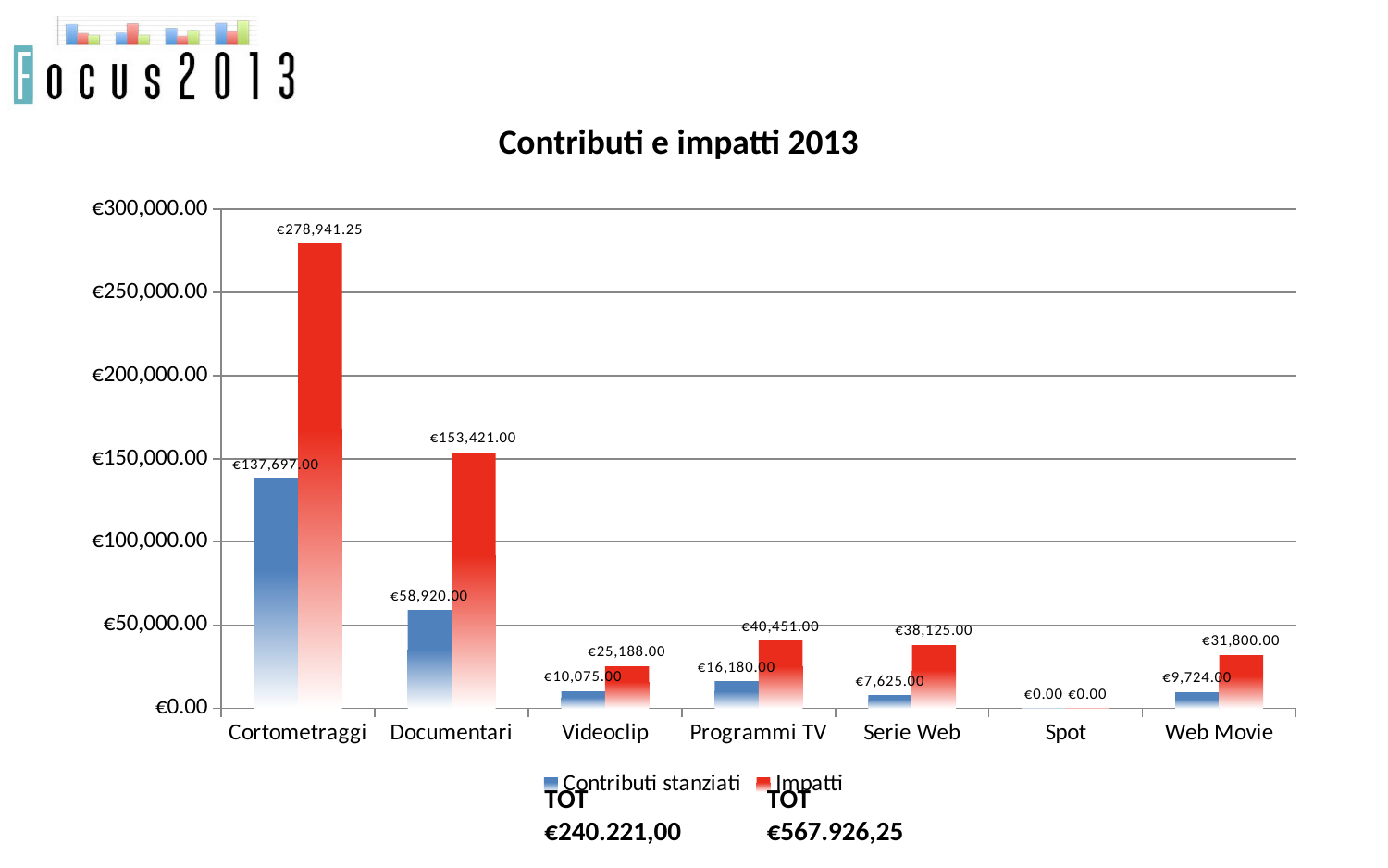
What is the Contributi stanziati value for Documentari? €58,920.00 Which series is shown in red? Impatti Which category has the lowest Contributi stanziati value? Spot How many categories are shown on the x axis? 7 What is the difference between the Impatti and Contributi stanziati values for Documentari? €94,501.00 What is the Impatti value for Serie Web? €38,125.00 Which category has the highest Impatti value? Cortometraggi What is the Impatti value for Cortometraggi? €278,941.25 What is the title of the chart? Contributi e impatti 2013 Which is larger, the Impatti value for Programmi TV or the Impatti value for Web Movie? Programmi TV How many series does the legend list? 2 What type of chart is shown on the slide? bar chart